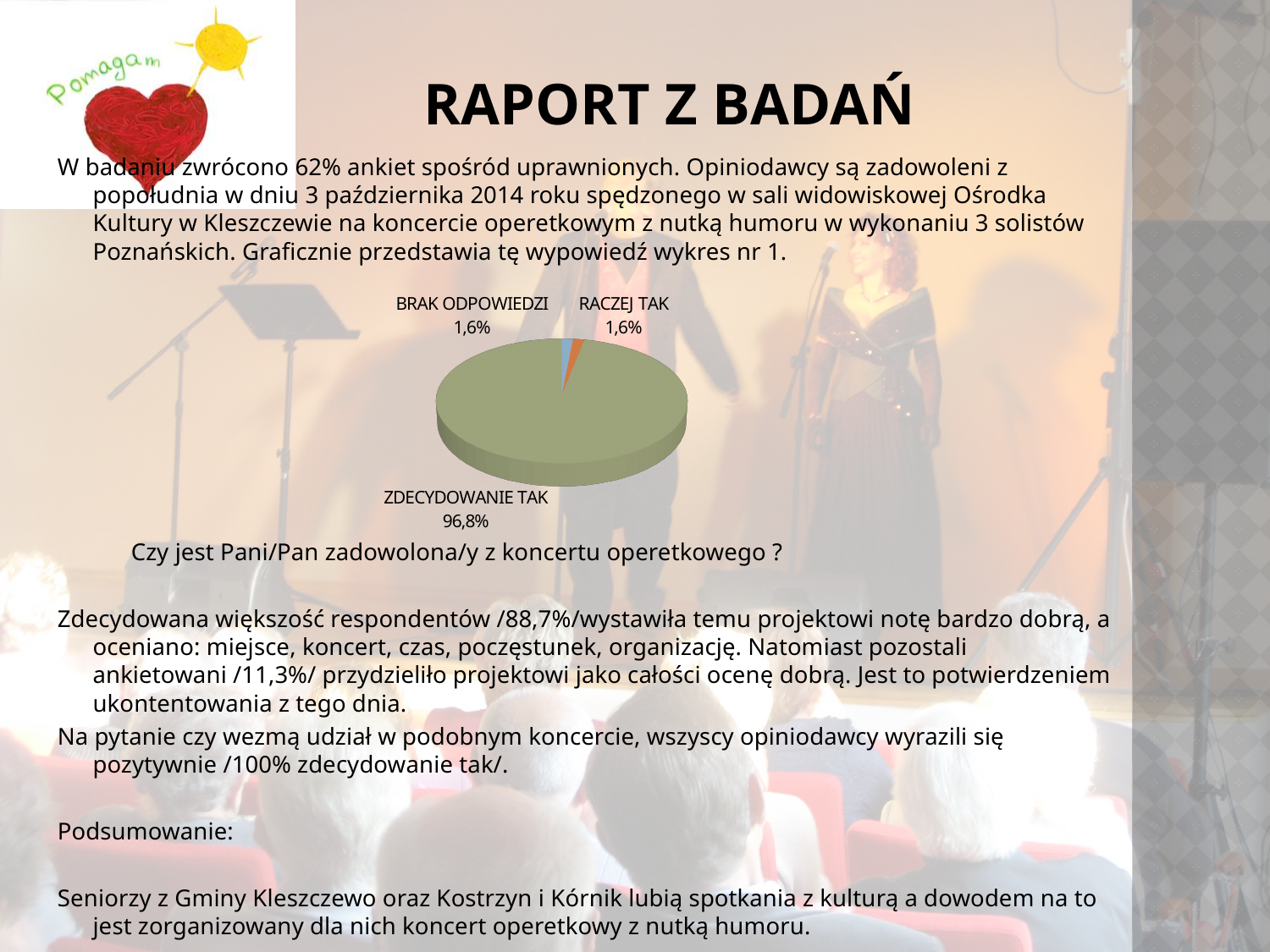
What is the difference between the ZDECYDOWANIE TAK share and the BRAK ODPOWIEDZI share? 95,2% What percentage does the ZDECYDOWANIE TAK slice show? 96,8% Which is larger, the ZDECYDOWANIE TAK slice or the RACZEJ TAK slice? ZDECYDOWANIE TAK How many slices does the pie chart have? 3 Do the RACZEJ TAK and BRAK ODPOWIEDZI slices show the same percentage? yes What colour is the largest slice of the pie chart? green What percentage does the RACZEJ TAK slice show? 1,6% What question is the pie chart answering, according to the caption below it? Czy jest Pani/Pan zadowolona/y z koncertu operetkowego ? What kind of chart is shown on the slide? pie chart What percentage does the BRAK ODPOWIEDZI slice show? 1,6% Which category has the largest slice of the pie? ZDECYDOWANIE TAK What share of the pie do the RACZEJ TAK and BRAK ODPOWIEDZI slices make up together? 3,2%